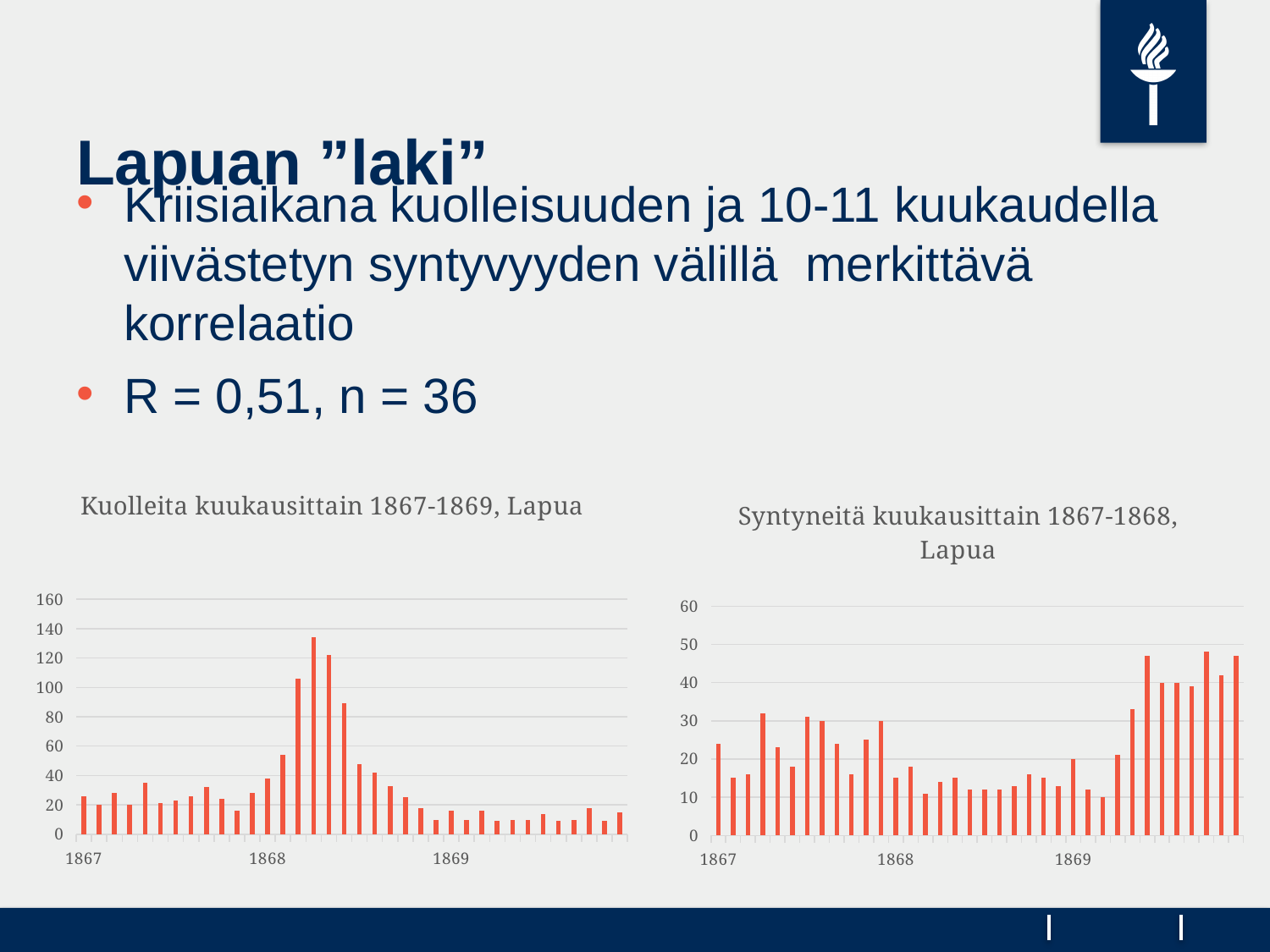
What is the title of the right chart on the slide? Syntyneitä kuukausittain 1867-1868, Lapua In the left chart 'Kuolleita kuukausittain 1867-1869, Lapua', is the first bar of 1867 greater or less than 40? less In the right chart 'Syntyneitä kuukausittain 1867-1868, Lapua', do the values generally rise or fall across 1869? rise In the left chart 'Kuolleita kuukausittain 1867-1869, Lapua', is the highest bar greater or less than 120? greater How many bars are plotted in the left chart 'Kuolleita kuukausittain 1867-1869, Lapua'? 36 In the left chart 'Kuolleita kuukausittain 1867-1869, Lapua', in which year does the highest bar occur? 1868 What is the highest value shown on the y axis of the left chart 'Kuolleita kuukausittain 1867-1869, Lapua'? 160 In the right chart 'Syntyneitä kuukausittain 1867-1868, Lapua', is the first bar of 1867 greater or less than 30? less In the right chart 'Syntyneitä kuukausittain 1867-1868, Lapua', in which year do the highest bars occur? 1869 What kind of chart is the right chart, 'Syntyneitä kuukausittain 1867-1868, Lapua'? bar chart What kind of chart is the left chart, 'Kuolleita kuukausittain 1867-1869, Lapua'? bar chart